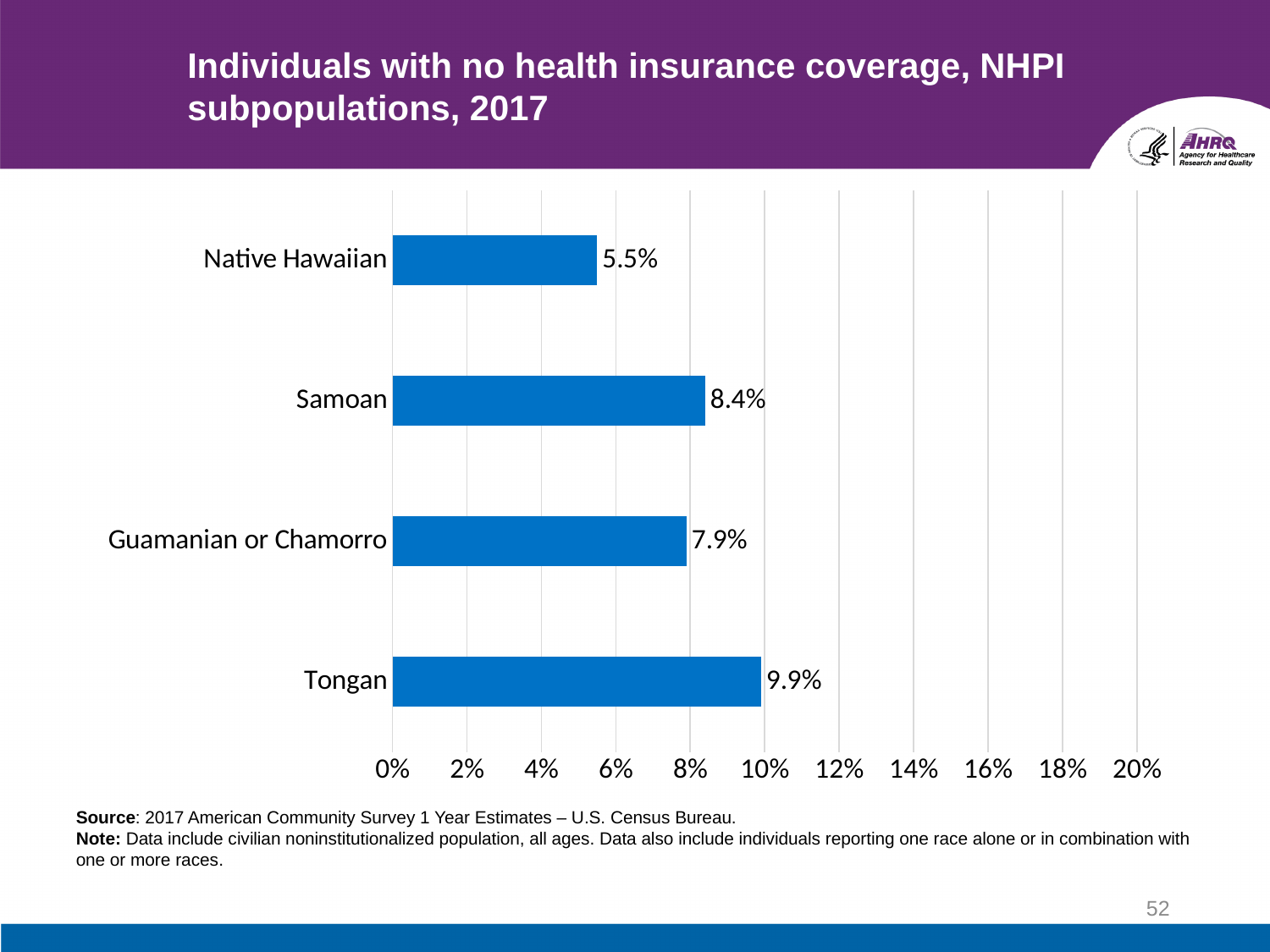
What is the percentage of Native Hawaiian individuals with no health insurance coverage? 5.5% Which subpopulation has the highest percentage with no health insurance coverage? Tongan What is the value shown for Tongan? 9.9% What is the difference between the Tongan and Native Hawaiian values? 4.4% What is the difference between the Samoan and Guamanian or Chamorro values? 0.5% Which subpopulation has the lowest percentage with no health insurance coverage? Native Hawaiian What is the maximum value shown on the x axis? 20% What is the value shown for Samoan? 8.4% Which is larger, the value for Samoan or the value for Native Hawaiian? Samoan What is the value shown for Guamanian or Chamorro? 7.9% What kind of chart is shown on the slide? Bar chart How many subpopulations are shown in the chart? 4